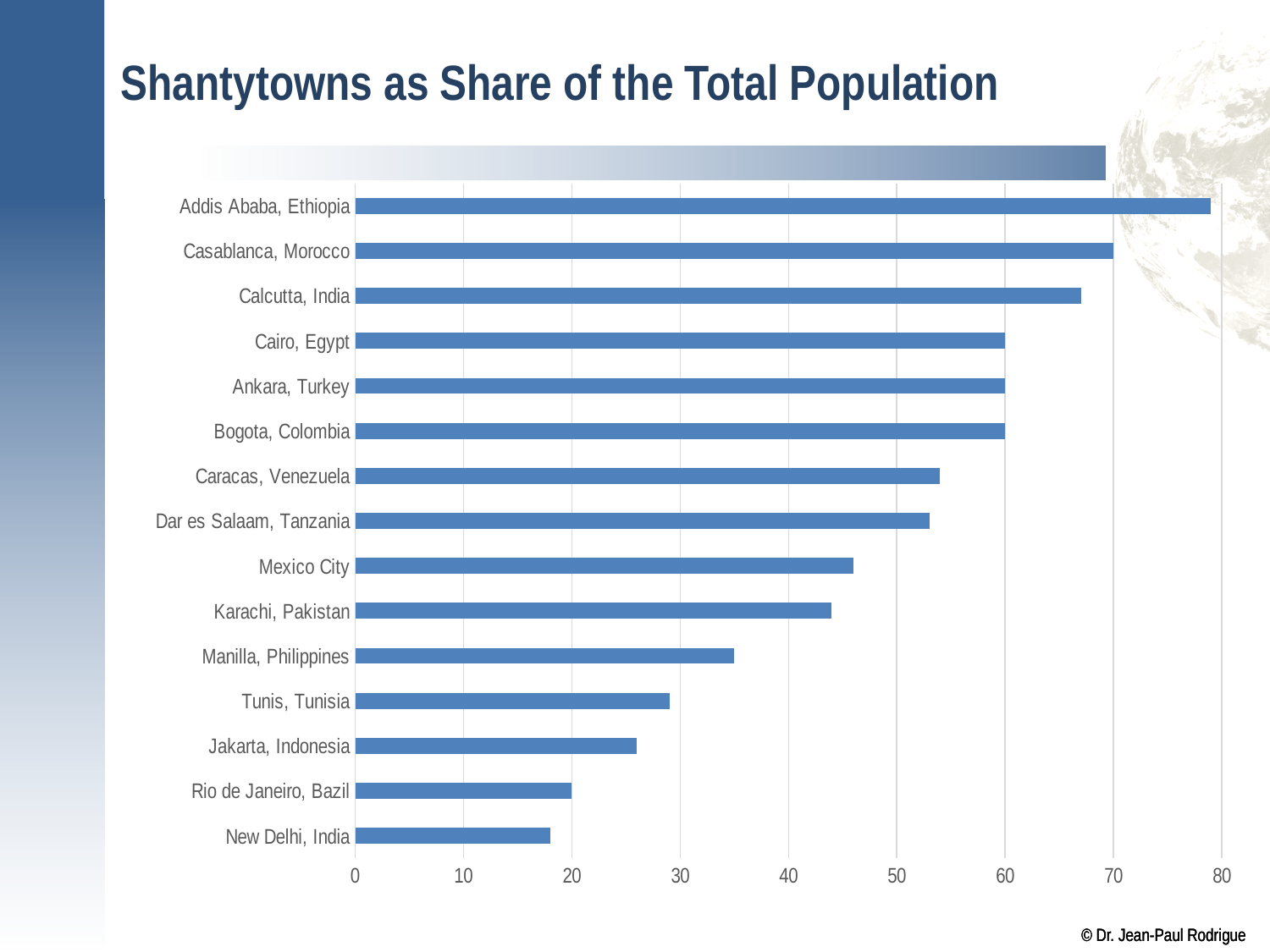
Which has a larger value, Calcutta, India or Caracas, Venezuela? Calcutta, India How many cities are listed on the chart? 15 What is the title of the chart? Shantytowns as Share of the Total Population Is the value for Addis Ababa, Ethiopia greater or less than 70? greater What is the value for Casablanca, Morocco? 70 Is the value for Manilla, Philippines greater or less than 40? less Is the value for Karachi, Pakistan greater or less than 40? greater Which city has the lowest shantytown share of total population? New Delhi, India What is the value for Cairo, Egypt? 60 Which city has the highest shantytown share of total population? Addis Ababa, Ethiopia What kind of chart is shown on the slide? Bar chart What is the value for Rio de Janeiro, Bazil? 20